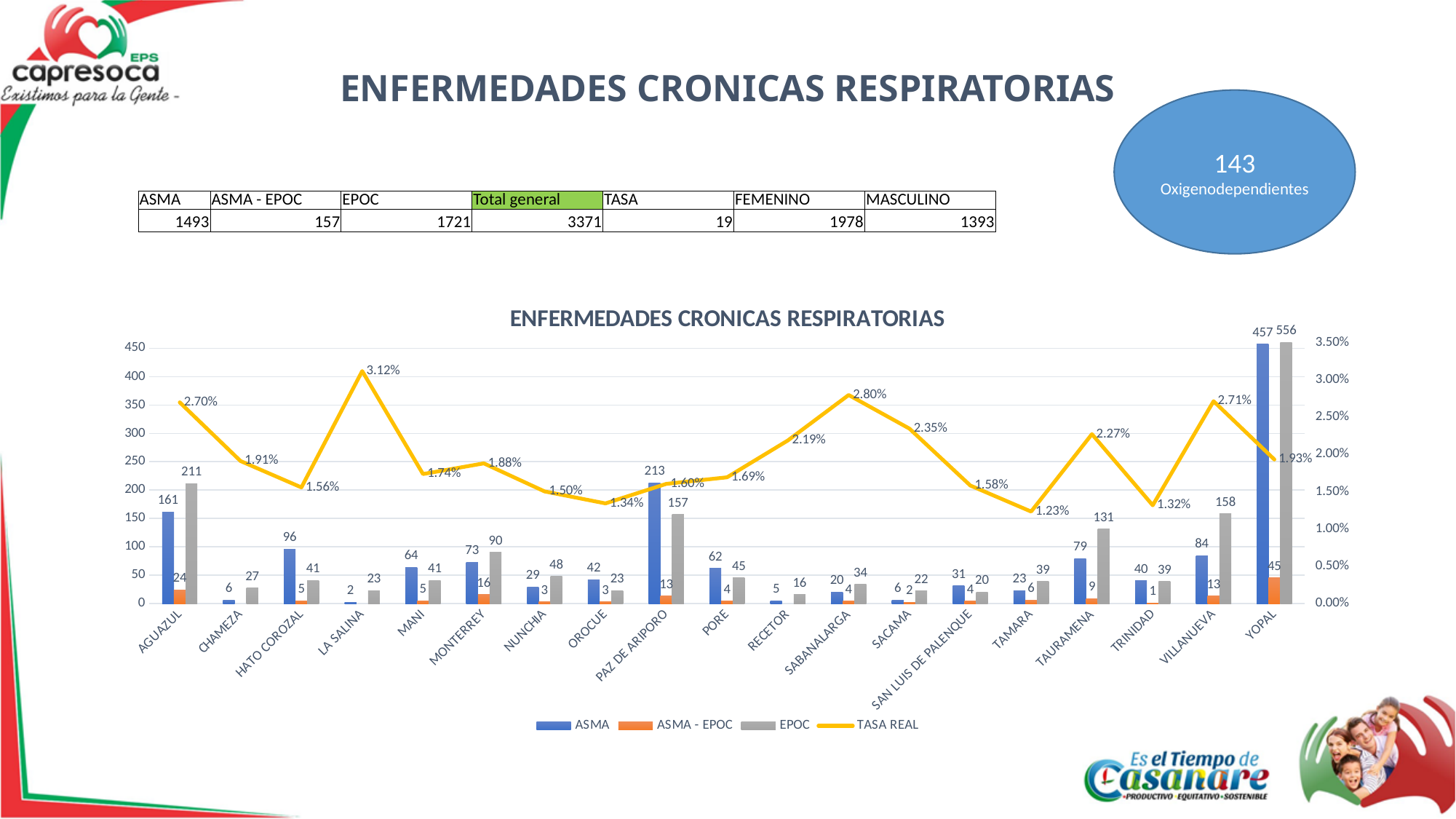
Which municipality has the lowest TASA REAL value? TAMARA What is the ASMA - EPOC value for MONTERREY? 16 What is the EPOC value for TAURAMENA? 131 What is the TASA REAL value for LA SALINA? 3.12% How many series does the legend list? 4 What is the difference between the EPOC and ASMA values for AGUAZUL? 50 What kind of chart is used to show the ASMA, ASMA - EPOC and EPOC series? Bar chart Which is larger for PAZ DE ARIPORO, the ASMA value or the EPOC value? ASMA Which series is drawn as a yellow line? TASA REAL How many municipalities are shown on the x axis? 19 What is the ASMA value for YOPAL? 457 Which municipality has the highest EPOC value? YOPAL